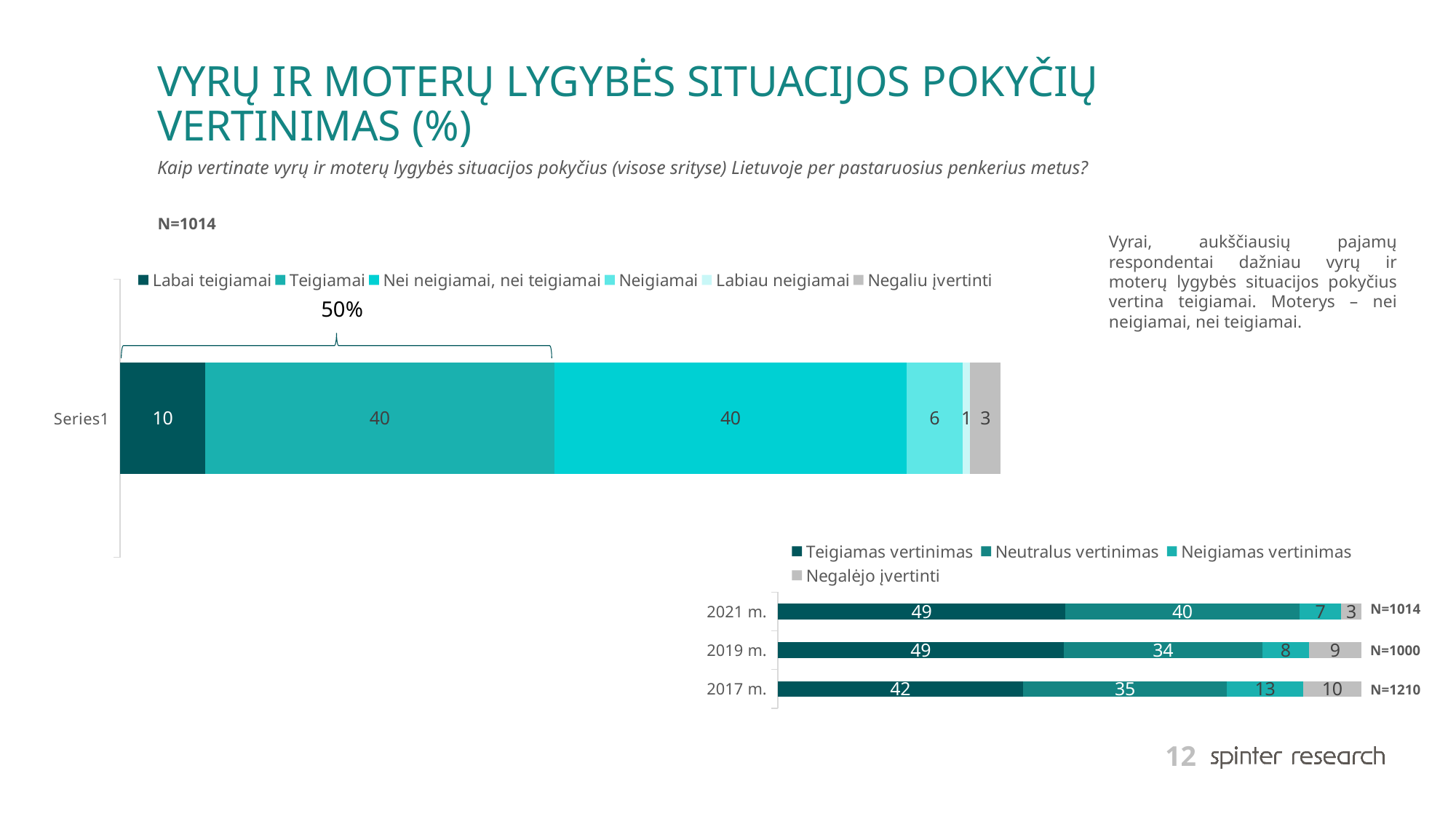
In the bottom chart, what is the value for "Neigiamas vertinimas" in 2019 m.? 8 In the top chart, what is the combined value of "Labai teigiamai" and "Teigiamai" as marked by the bracket? 50% In the top chart, what is the value for "Neigiamai"? 6 How many years are shown in the bottom chart? 3 In the top chart, what is the value for "Labai teigiamai"? 10 How many series does the legend of the top chart list? 6 In the bottom chart, what is the value for "Teigiamas vertinimas" in 2017 m.? 42 In the bottom chart, is the "Negalėjo įvertinti" value larger in 2017 m. or in 2021 m.? 2017 m. In the bottom chart, what is the difference between the "Neutralus vertinimas" values for 2021 m. and 2019 m.? 6 In the bottom chart, what is the value for "Negalėjo įvertinti" in 2021 m.? 3 In the bottom chart, which year has the lowest value for "Teigiamas vertinimas"? 2017 m. In the top chart, what is the value for "Negaliu įvertinti"? 3